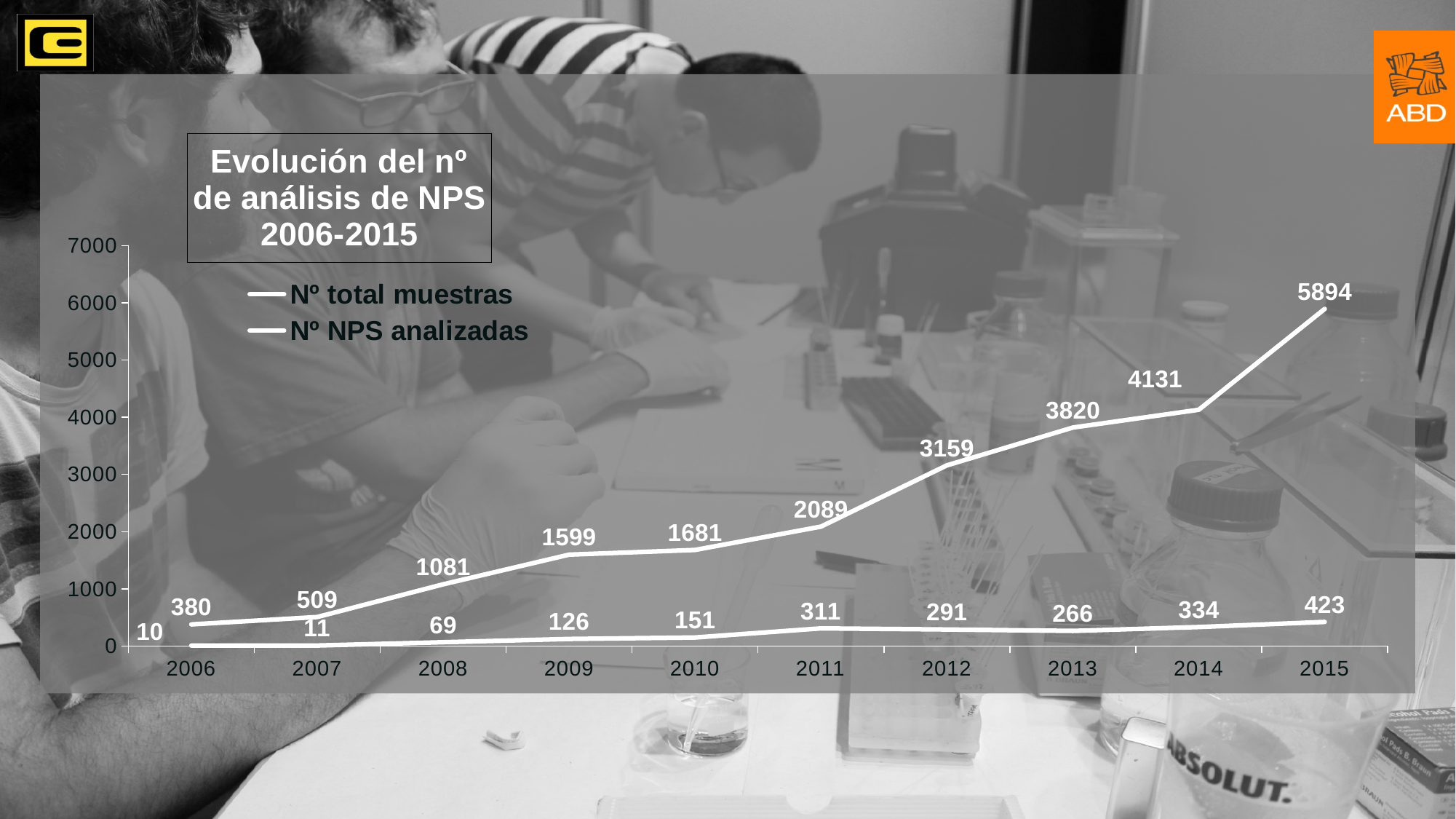
What is the difference between Nº total muestras in 2015 and in 2014? 1763 What type of chart is shown on the slide? line chart What is the difference between Nº NPS analizadas in 2014 and in 2013? 68 How many series does the legend list? 2 Does Nº total muestras generally rise or fall from 2006 to 2015? rise What is the value of Nº NPS analizadas in 2011? 311 In which year is Nº NPS analizadas highest? 2015 What is the title of the chart? Evolución del nº de análisis de NPS 2006-2015 How many years are shown on the x axis? 10 Which is larger: Nº NPS analizadas in 2012 or in 2013? 2012 What is the value of Nº total muestras in 2015? 5894 In which year is Nº total muestras lowest? 2006